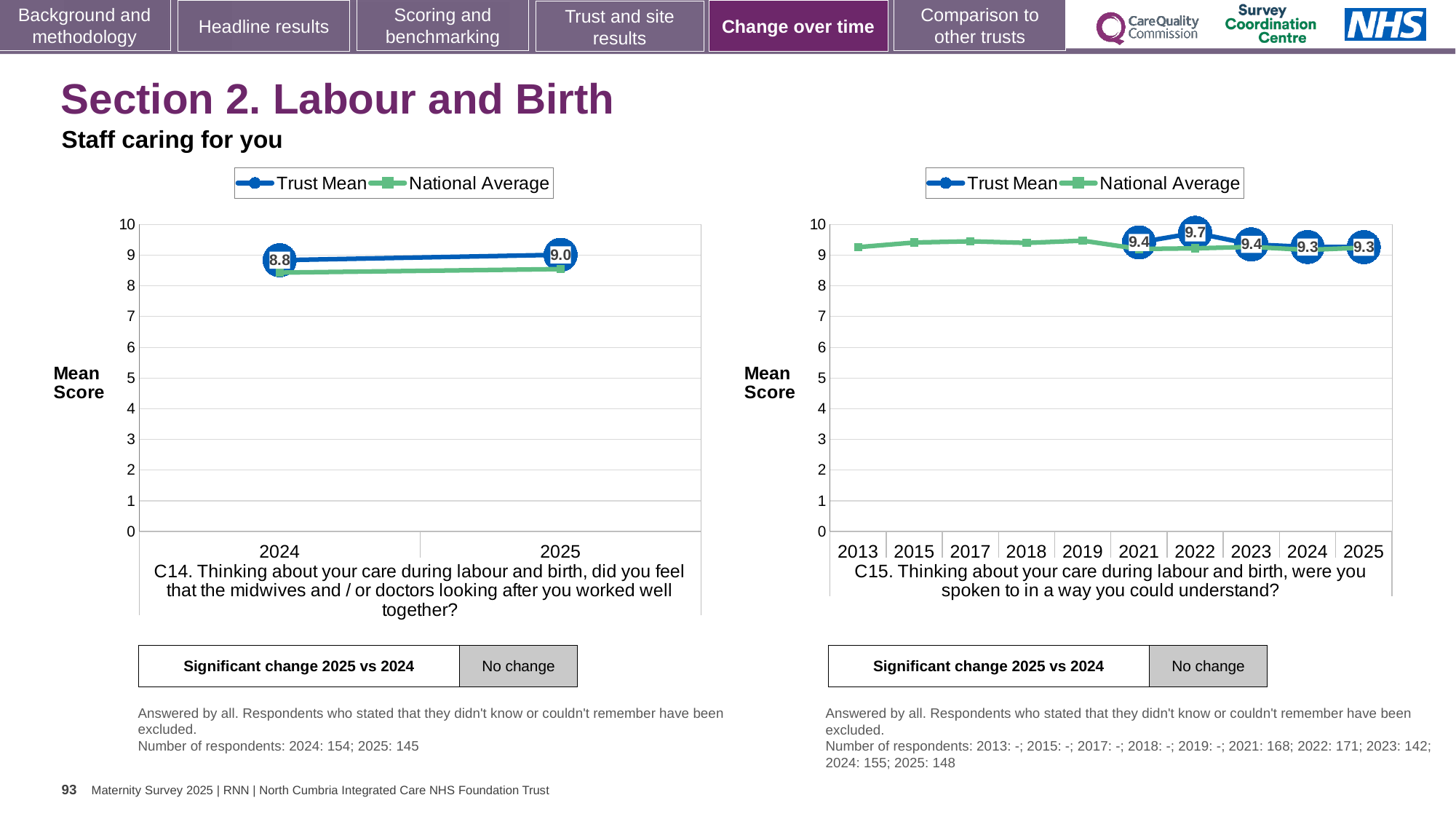
In the left chart (C14), what is the Trust Mean score for 2024? 8.8 In the right chart (C15), what is the difference between the Trust Mean in 2022 and in 2025? 0.4 How many series does the legend of the right chart (C15) list? 2 In the left chart (C14), what is the Trust Mean score for 2025? 9.0 What type of chart is the left chart (C14)? line chart In the left chart (C14), by how much did the Trust Mean change from 2024 to 2025? 0.2 In the right chart (C15), how many years are shown on the x axis? 10 In the left chart (C14), is the National Average value for 2024 greater or less than 9? less In the right chart (C15), which year has the highest Trust Mean score? 2022 In the right chart (C15), what is the Trust Mean score for 2022? 9.7 In the left chart (C14), does the Trust Mean rise or fall from 2024 to 2025? rise In the right chart (C15), which is larger, the Trust Mean for 2021 or for 2024? 2021